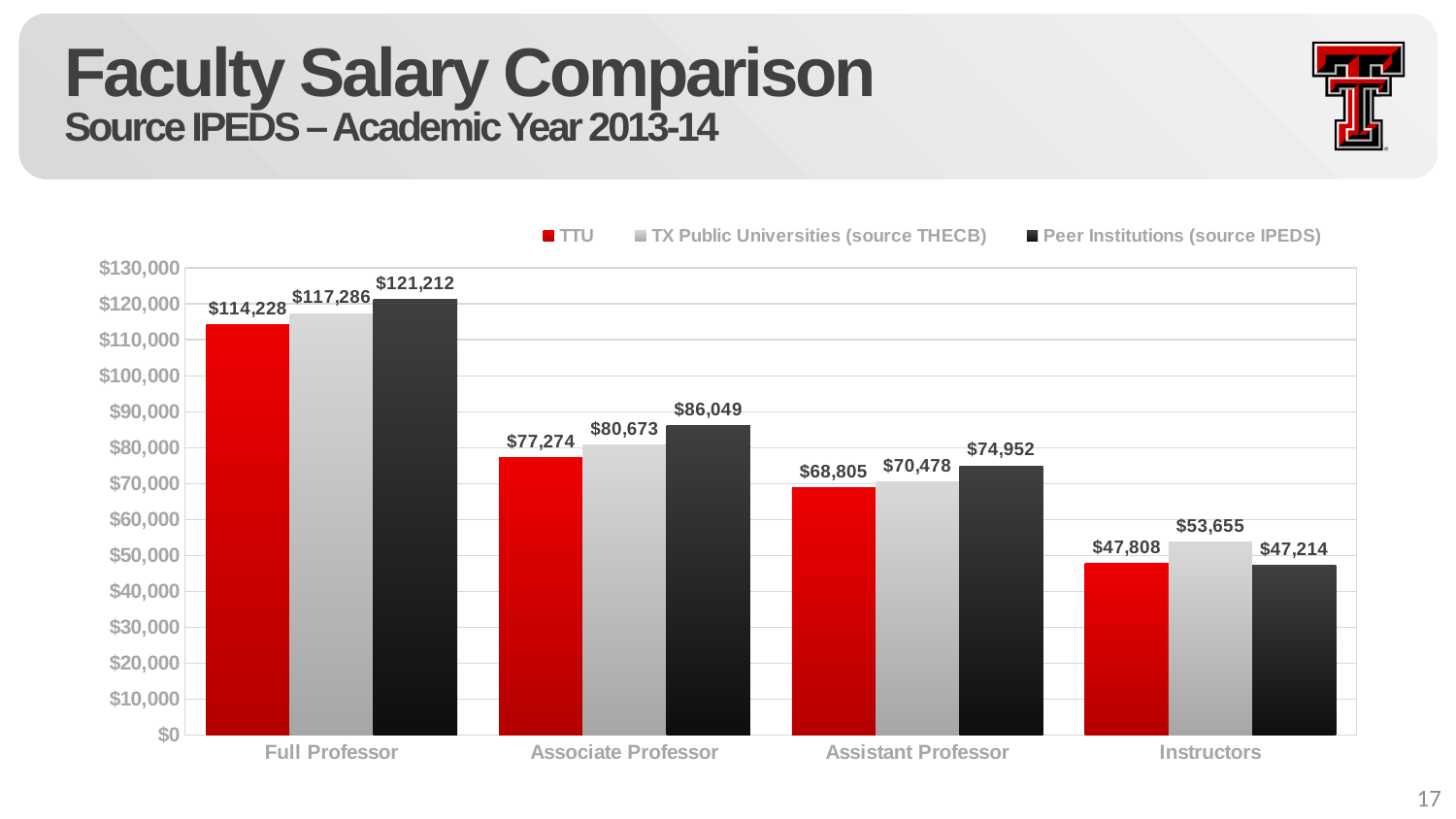
What is the TX Public Universities (source THECB) salary for Instructors? $53,655 What is the Peer Institutions (source IPEDS) salary for Associate Professor? $86,049 Which category has the highest Peer Institutions (source IPEDS) salary? Full Professor What is the TTU salary for Full Professor? $114,228 What is the difference between the TX Public Universities (source THECB) and TTU salaries for Assistant Professor? $1,673 What kind of chart is shown on the slide? bar chart Is the TTU salary for Associate Professor greater or less than $80,000? less How many faculty rank categories are shown on the x axis? 4 For Instructors, which is larger: the TTU salary or the Peer Institutions (source IPEDS) salary? TTU How many series does the legend list? 3 What is the difference between the Peer Institutions (source IPEDS) and TTU salaries for Full Professor? $6,984 Which category has the lowest TTU salary? Instructors